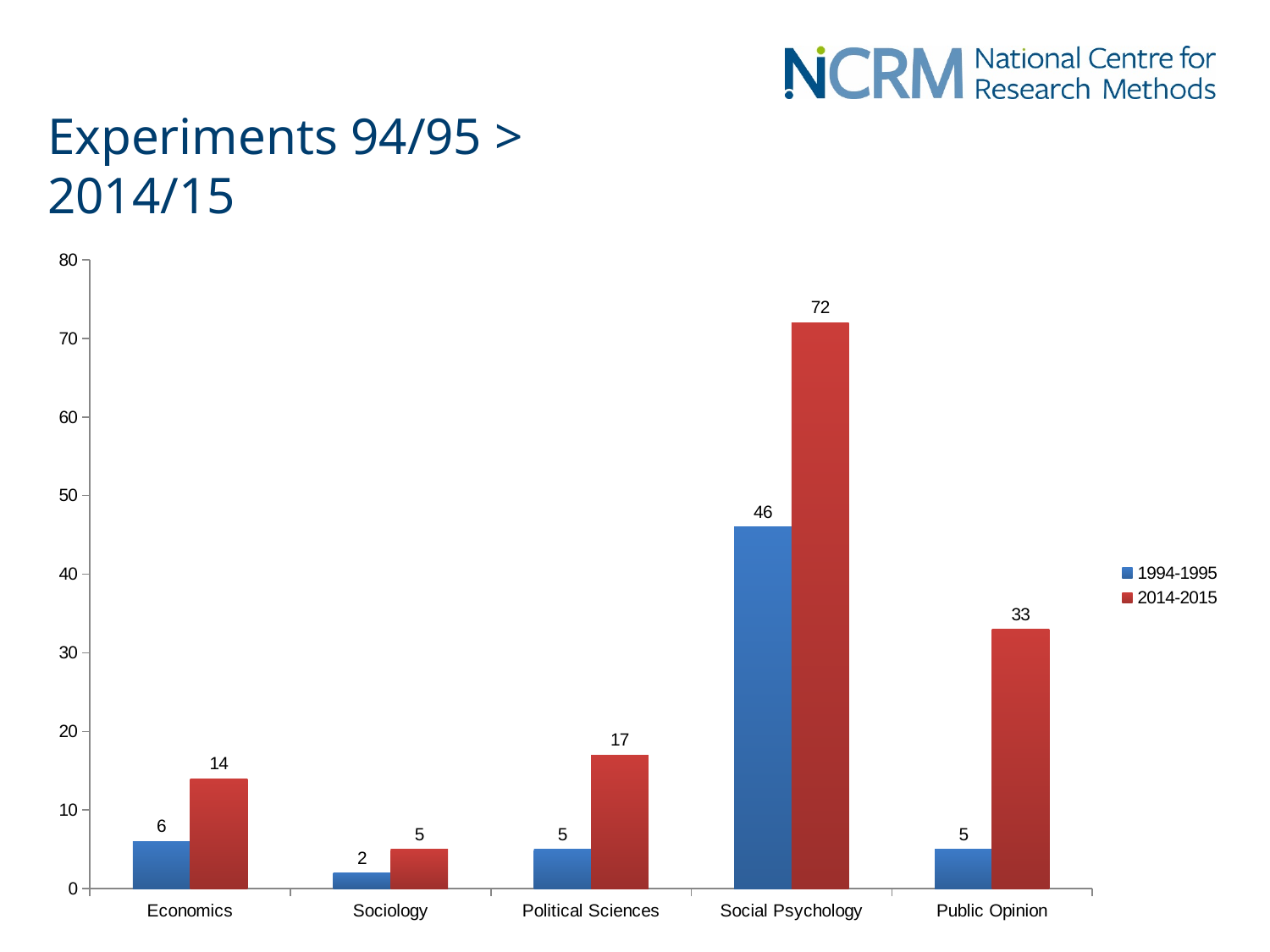
Is the 2014-2015 value for Public Opinion greater or less than 30? greater Which category has the highest value in the 1994-1995 series? Social Psychology What kind of chart is shown on the slide? bar chart Which colour represents the 2014-2015 series? red What is the value for Social Psychology in the 2014-2015 series? 72 How many categories are shown on the x axis? 5 What is the value for Economics in the 1994-1995 series? 6 What is the value for Public Opinion in the 2014-2015 series? 33 What is the difference between the 2014-2015 and 1994-1995 values for Social Psychology? 26 Which is larger: the 2014-2015 value for Political Sciences or the 2014-2015 value for Economics? Political Sciences Which category has the lowest value in the 2014-2015 series? Sociology How many series does the legend list? 2